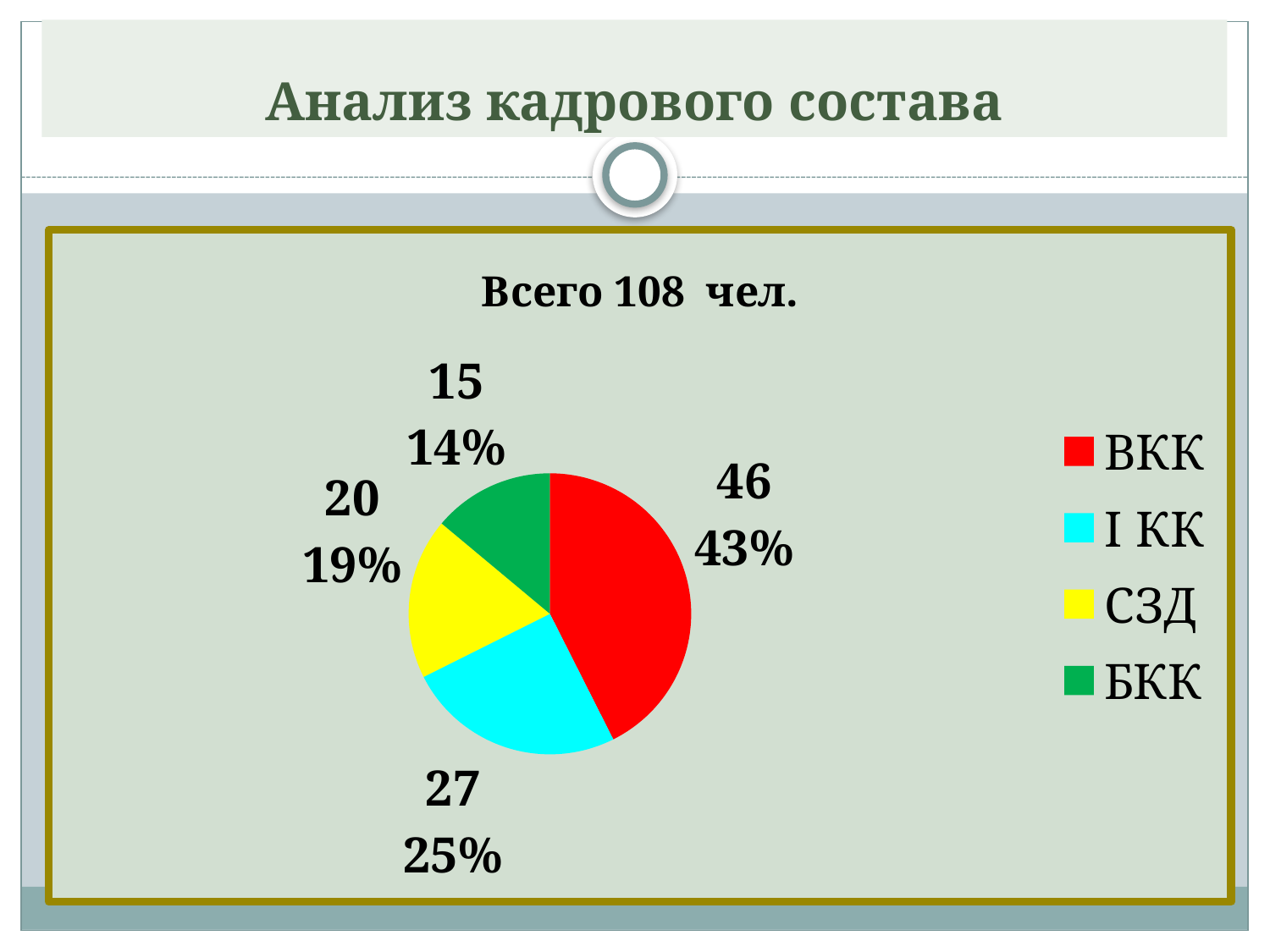
What is the value for I КК? 27 What share of the pie does СЗД represent? 19% How many categories does the legend list? 4 What kind of chart is shown on the slide? pie chart Which category has the smallest slice? БКК What is the value for БКК? 15 Which category has the largest slice? ВКК What is the chart's title? Всего 108 чел. What is the value for ВКК? 46 How many slices does the pie have? 4 What is the value for СЗД? 20 What is the difference between the values for ВКК and I КК? 19